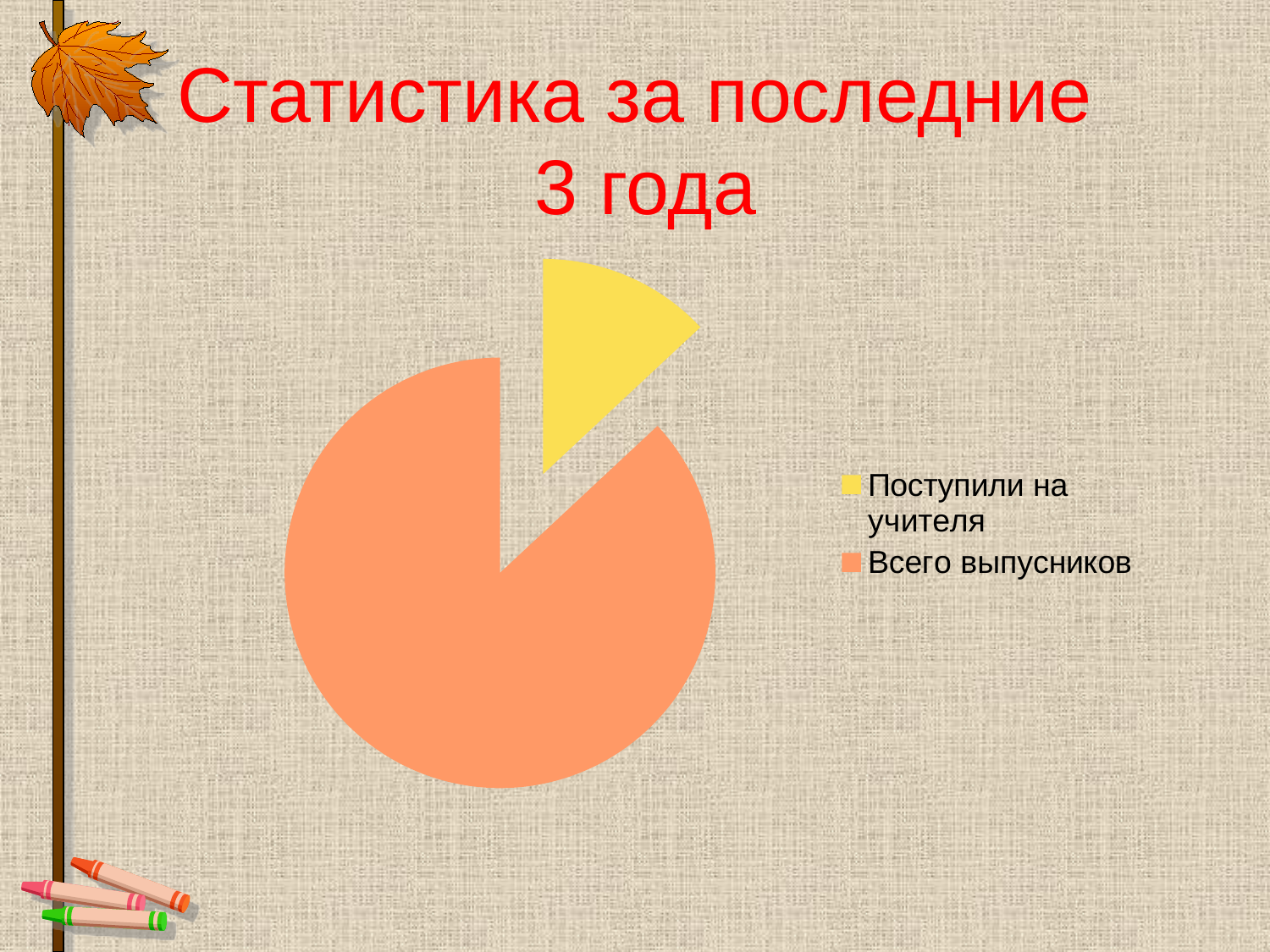
What kind of chart is shown on the slide? pie chart How many slices does the pie chart have? 2 How many entries does the legend of the pie chart list? 2 What is the title of the slide containing the pie chart? Статистика за последние 3 года Which slice is larger: "Поступили на учителя" or "Всего выпусников"? Всего выпусников Which category has the largest slice in the pie chart? Всего выпусников Which category has the smallest slice in the pie chart? Поступили на учителя What colour is the slice for "Поступили на учителя" in the pie chart? yellow